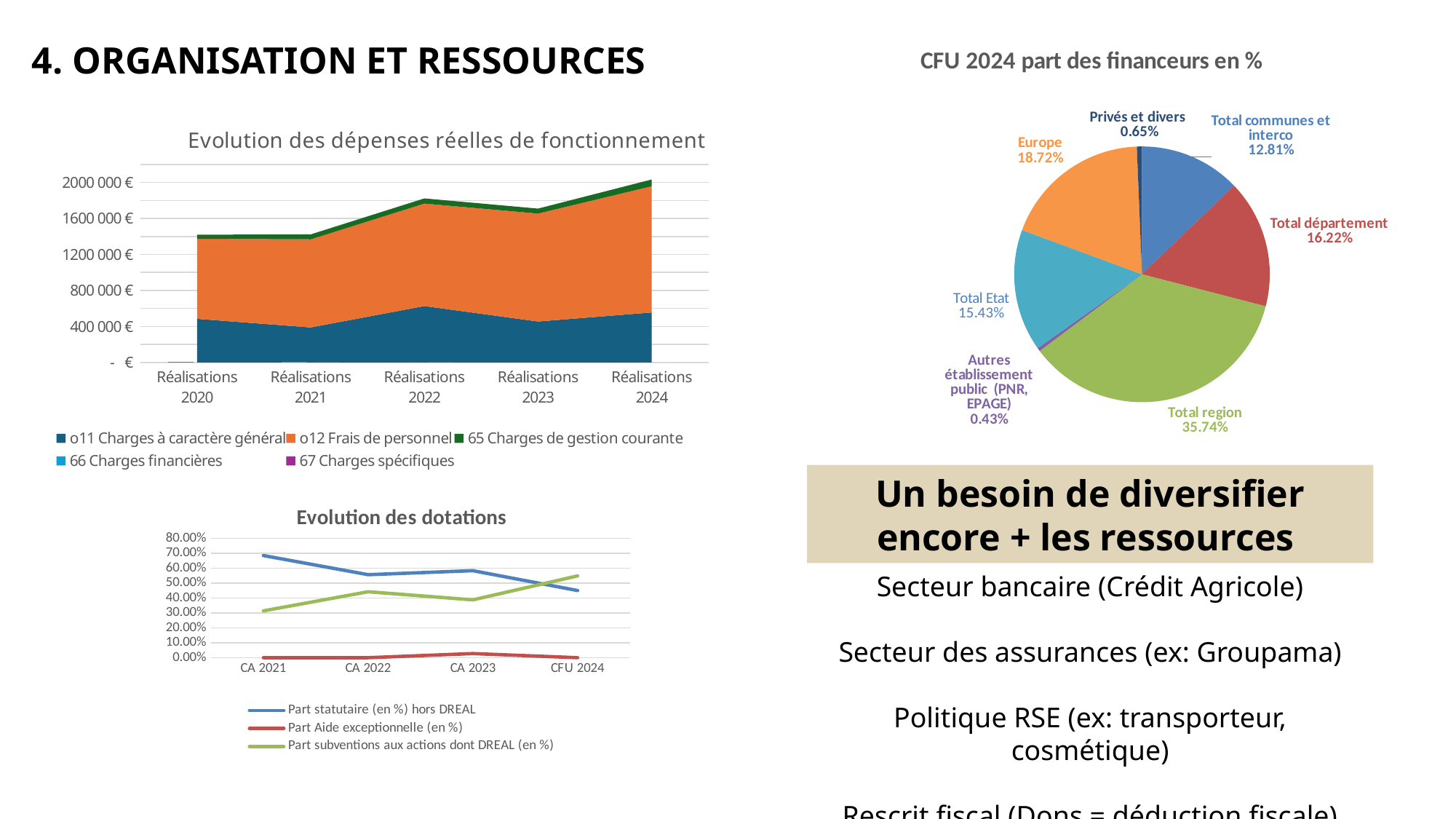
How many series does the legend of 'Evolution des dotations' list? 3 How many series does the legend of 'Evolution des dépenses réelles de fonctionnement' list? 5 In the pie chart 'CFU 2024 part des financeurs en %', what is the share for 'Europe'? 18.72% What kind of chart is 'Evolution des dépenses réelles de fonctionnement'? Stacked area chart In the chart 'Evolution des dotations', does 'Part statutaire (en %) hors DREAL' rise or fall from CA 2021 to CFU 2024? fall In the pie chart 'CFU 2024 part des financeurs en %', which is larger: the share of 'Europe' or of 'Total communes et interco'? Europe In the pie chart 'CFU 2024 part des financeurs en %', which financer has the smallest share? Autres établissement public (PNR, EPAGE) In the chart 'Evolution des dépenses réelles de fonctionnement', is the value for 'o11 Charges à caractère général' in Réalisations 2020 greater or less than 800 000 €? less In the pie chart 'CFU 2024 part des financeurs en %', what share does 'Total region' have? 35.74% In the pie chart 'CFU 2024 part des financeurs en %', which financer has the largest share? Total region How many slices does the pie chart 'CFU 2024 part des financeurs en %' have? 7 In the pie chart 'CFU 2024 part des financeurs en %', what is the difference between the shares of 'Total département' and 'Total Etat'? 0.79%